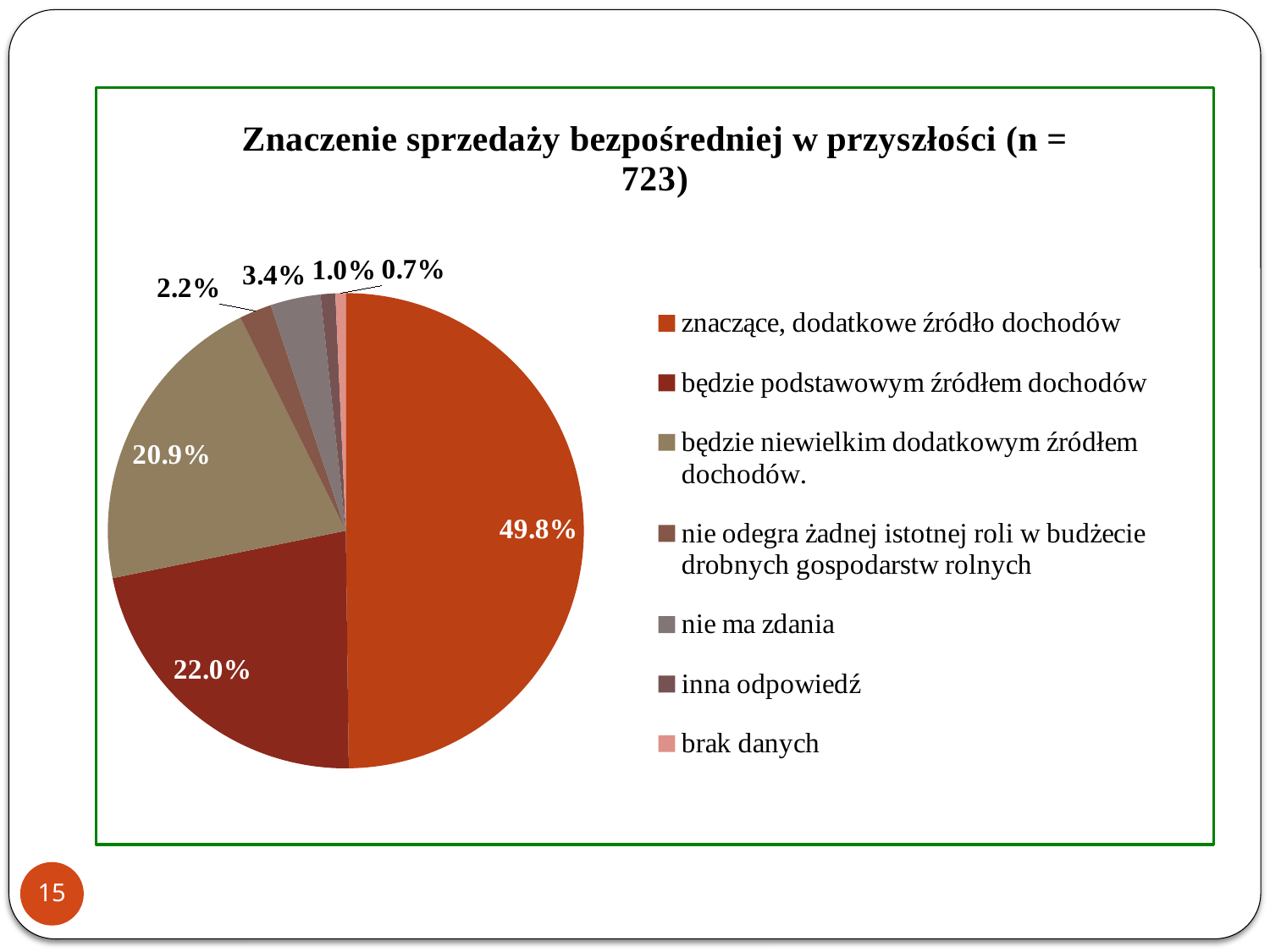
What percentage corresponds to "będzie podstawowym źródłem dochodów"? 22.0% Which category has the largest slice of the pie? znaczące, dodatkowe źródło dochodów What is the sample size (n) given in the chart title? 723 What percentage of respondents answered "nie ma zdania"? 3.4% How many categories does the legend of the pie chart list? 7 What share of respondents said direct sales will be a significant, additional source of income ("znaczące, dodatkowe źródło dochodów")? 49.8% What is the difference in percentage points between "będzie podstawowym źródłem dochodów" and "będzie niewielkim dodatkowym źródłem dochodów"? 1.1 percentage points What percentage corresponds to "będzie niewielkim dodatkowym źródłem dochodów"? 20.9% Which category has the smallest slice of the pie? brak danych What percentage is shown for "brak danych"? 0.7% Which is larger: the share for "nie ma zdania" or the share for "nie odegra żadnej istotnej roli w budżecie drobnych gospodarstw rolnych"? nie ma zdania What kind of chart is shown on the slide? pie chart